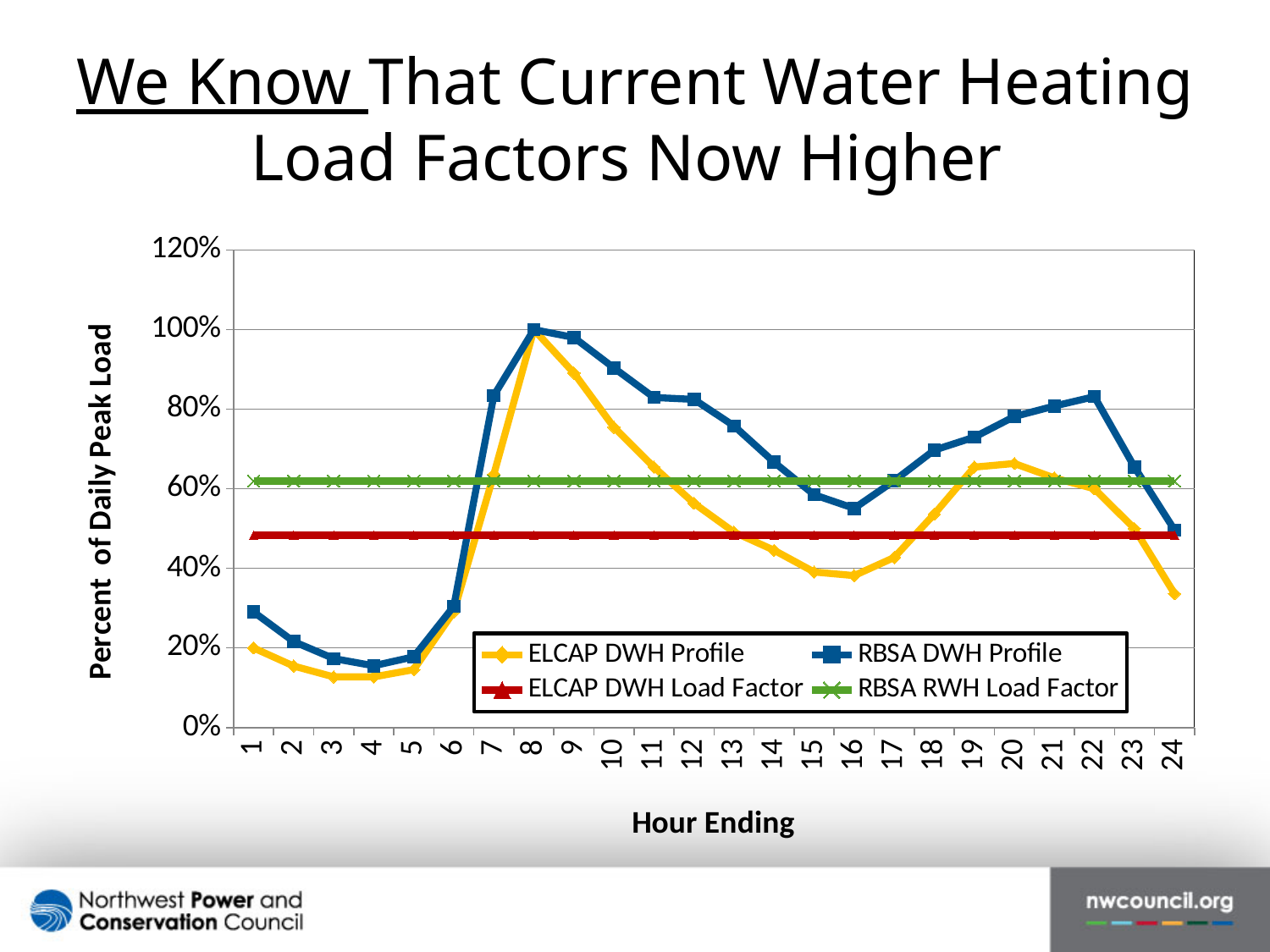
At which hour ending does the ELCAP DWH Profile reach its highest value? 8 What is the title of the y axis? Percent of Daily Peak Load Is the RBSA DWH Profile value at hour ending 22 greater or less than 80%? greater What kind of chart is shown on the slide? line chart Which horizontal line is higher: the RBSA RWH Load Factor or the ELCAP DWH Load Factor? RBSA RWH Load Factor At hour ending 12, which is larger: the RBSA DWH Profile or the ELCAP DWH Profile? RBSA DWH Profile At which hour ending does the RBSA DWH Profile reach its highest value? 8 How many hours are plotted along the x axis? 24 Is the RBSA DWH Profile value at hour ending 16 greater or less than 60%? less Is the ELCAP DWH Profile value at hour ending 4 greater or less than 20%? less Does the RBSA DWH Profile rise or fall from hour ending 8 to hour ending 16? fall How many series does the legend list? 4